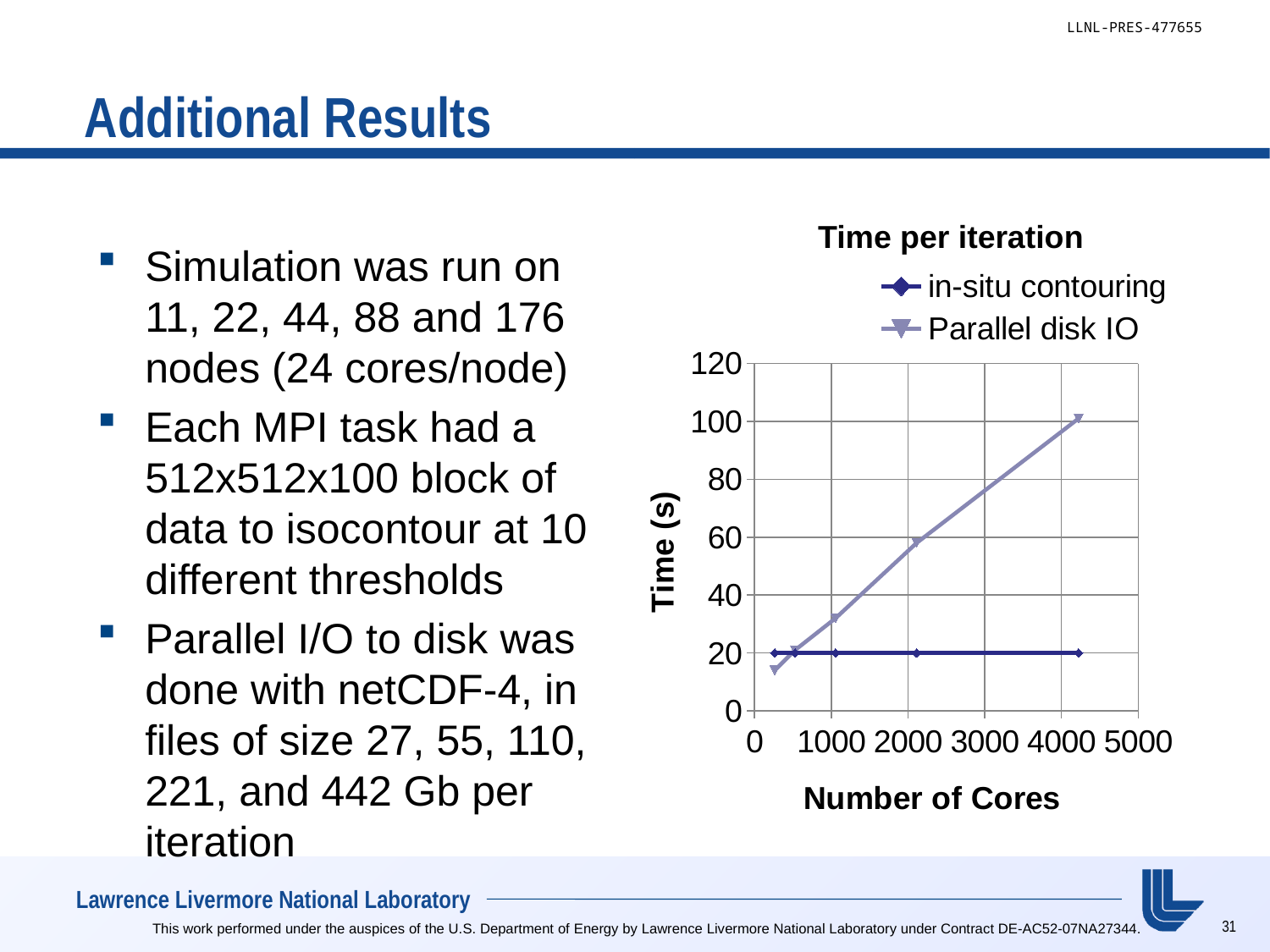
Is the value for Parallel disk IO at about 2000 cores greater or less than 40? greater Is the value for Parallel disk IO at the highest number of cores greater or less than 80? greater Which series reaches the highest time per iteration on the chart? Parallel disk IO What is the label of the y axis of the chart? Time (s) How many data points are plotted for the Parallel disk IO series? 5 At the highest number of cores, which series has the larger time per iteration, in-situ contouring or Parallel disk IO? Parallel disk IO Is the value for in-situ contouring at the highest number of cores greater or less than 40? less What kind of chart is shown on the slide? line chart Does the time for in-situ contouring rise, fall, or stay roughly flat as the number of cores increases? stay roughly flat How many series does the legend of the chart list? 2 Does the time for Parallel disk IO rise or fall as the number of cores increases? rise What is the title of the chart? Time per iteration